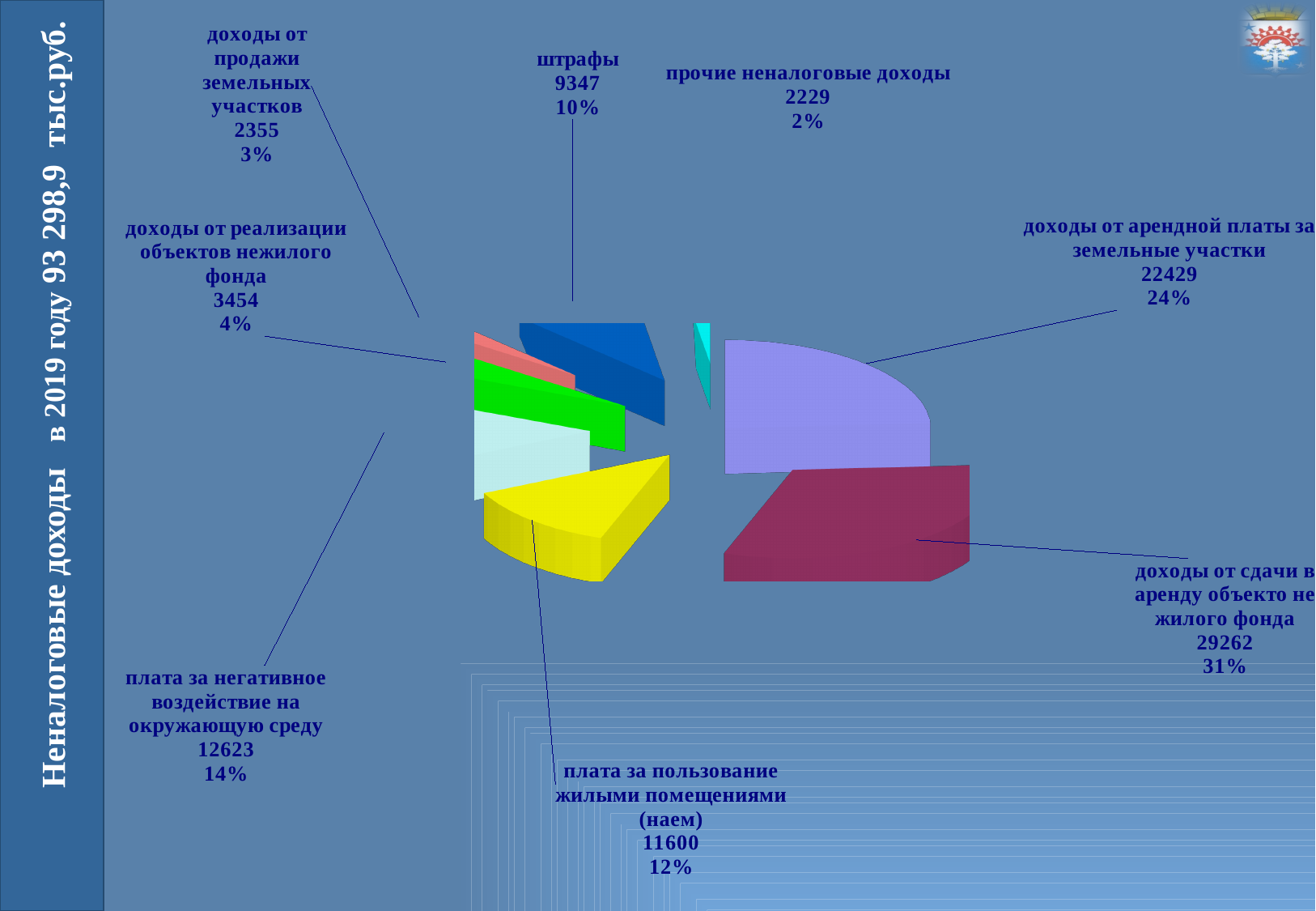
What is the value for доходы от продажи земельных участков? 2355 What is the value for плата за негативное воздействие на окружающую среду? 12623 What is the difference between доходы от сдачи в аренду объекто нежилого фонда and доходы от арендной платы за земельные участки? 6833 What share of the pie is доходы от арендной платы за земельные участки? 24% What is the value for штрафы? 9347 How many categories does the pie chart have? 8 What kind of chart is shown on the slide? pie chart Which category has the smallest value? прочие неналоговые доходы Which category has the largest value? доходы от сдачи в аренду объекто нежилого фонда What share of the pie is доходы от реализации объектов нежилого фонда? 4% Which is larger: плата за пользование жилыми помещениями (наем) or плата за негативное воздействие на окружающую среду? плата за негативное воздействие на окружающую среду What total amount of non-tax revenue for 2019 is stated in the slide title? 93 298,9 тыс.руб.